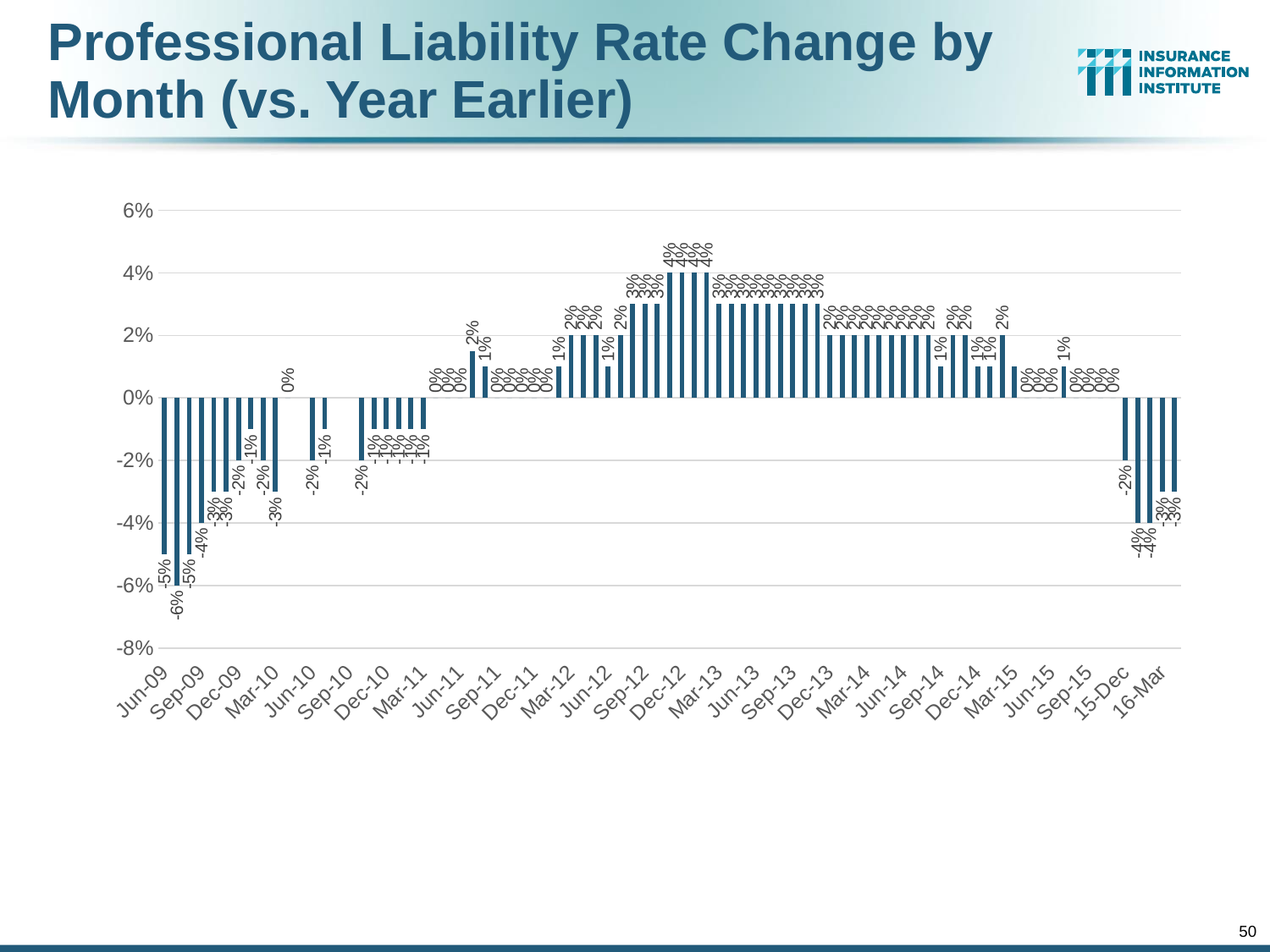
What is the highest value shown on the vertical axis? 6% What kind of chart is shown on the slide? bar chart Which has the larger rate change, Jun-09 or Dec-12? Dec-12 What is the difference between the rate change for Dec-12 and the rate change for Jun-09? 9 percentage points What is the highest rate change shown on the chart? 4% Is the rate change for Dec-12 greater or less than 2%? greater Is the rate change for Jun-09 greater or less than -4%? less What is the rate change for Dec-12? 4% What is the rate change for Jun-09? -5% What is the lowest rate change shown on the chart? -6% What is the title of the chart? Professional Liability Rate Change by Month (vs. Year Earlier) Do the rate changes generally rise or fall from Jun-09 to Dec-12? rise